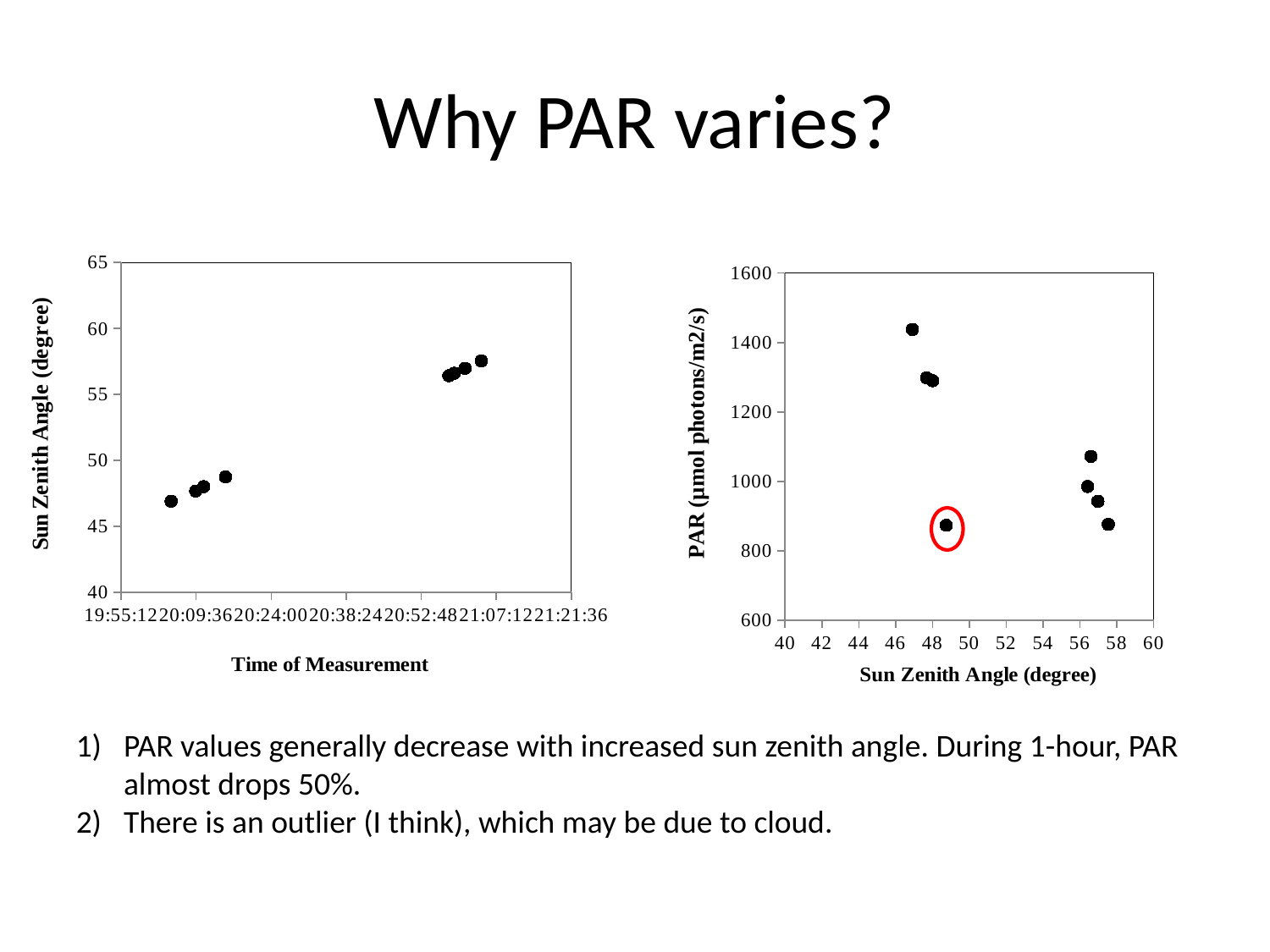
In the right chart, is the lowest PAR value among the points near 57 degrees greater or less than 1000? less In the right chart, is the PAR value of the highest point greater or less than 1400? greater In the right chart, which has the higher PAR value: the points near a sun zenith angle of 47 degrees or the points near 57 degrees? the points near 47 degrees What is the y-axis label of the right chart? PAR (µmol photons/m2/s) What is the x-axis label of the left chart? Time of Measurement What kind of chart is the left chart (Sun Zenith Angle vs Time of Measurement)? scatter chart In the left chart, is the sun zenith angle of the latest measurement greater or less than 55? greater What kind of chart is the right chart (PAR vs Sun Zenith Angle)? scatter chart In the left chart, does the sun zenith angle rise or fall as the time of measurement increases? rise In the right chart, do PAR values generally rise or fall as the sun zenith angle increases? fall